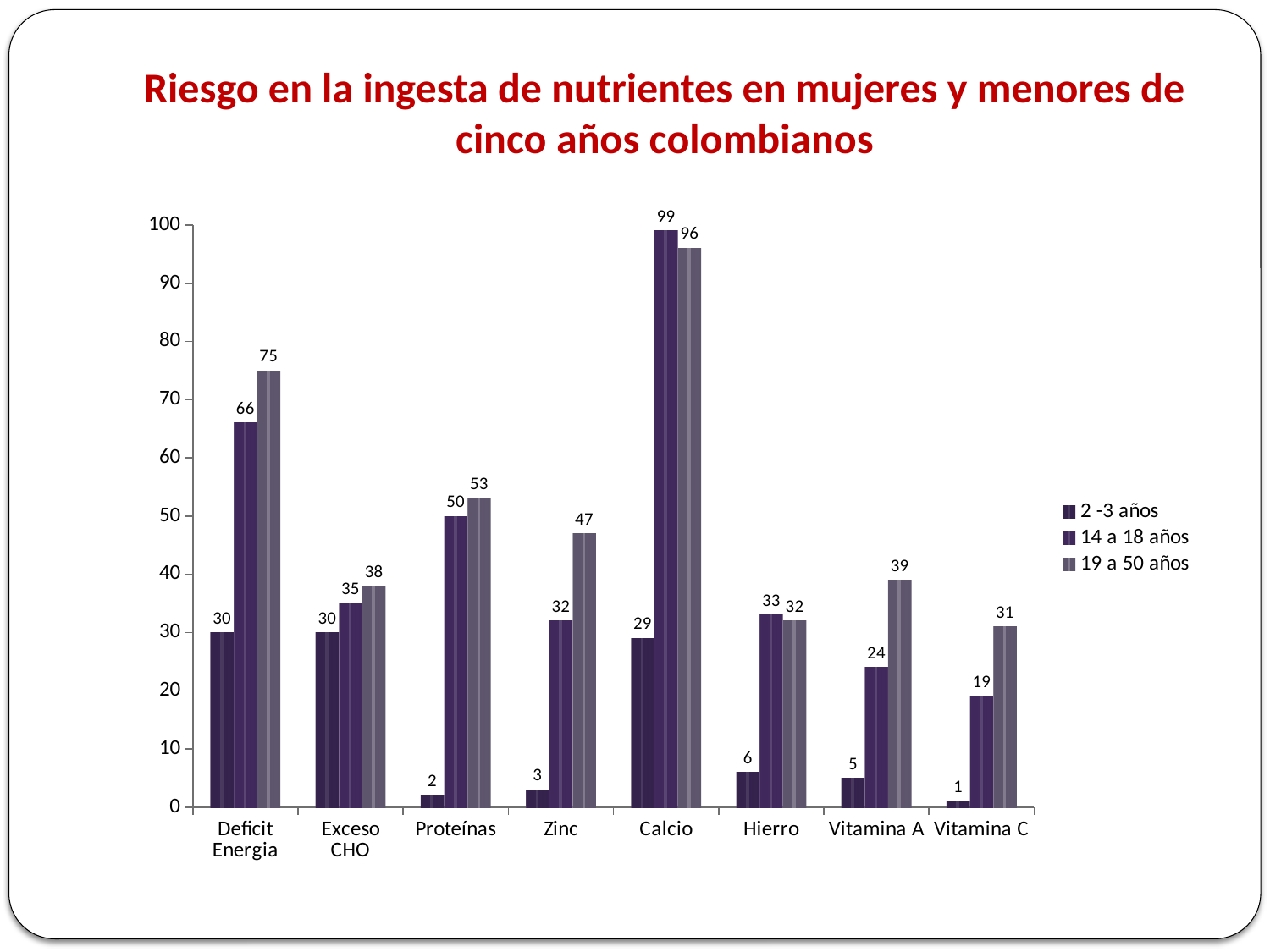
What is the title of the chart? Riesgo en la ingesta de nutrientes en mujeres y menores de cinco años colombianos What kind of chart is shown on the slide? Bar chart Is the value for Hierro in the 14 a 18 años series greater or less than 30? greater Which category has the lowest value in the 2 -3 años series? Vitamina C What is the value for Proteínas in the 2 -3 años series? 2 What is the difference between the 19 a 50 años and 14 a 18 años values for Deficit Energia? 9 What is the value for Calcio in the 14 a 18 años series? 99 How many categories are shown on the x axis? 8 What is the value for Vitamina A in the 19 a 50 años series? 39 How many series does the legend list? 3 Which is larger for Zinc: the 14 a 18 años value or the 19 a 50 años value? 19 a 50 años Which category has the highest value in the 19 a 50 años series? Calcio